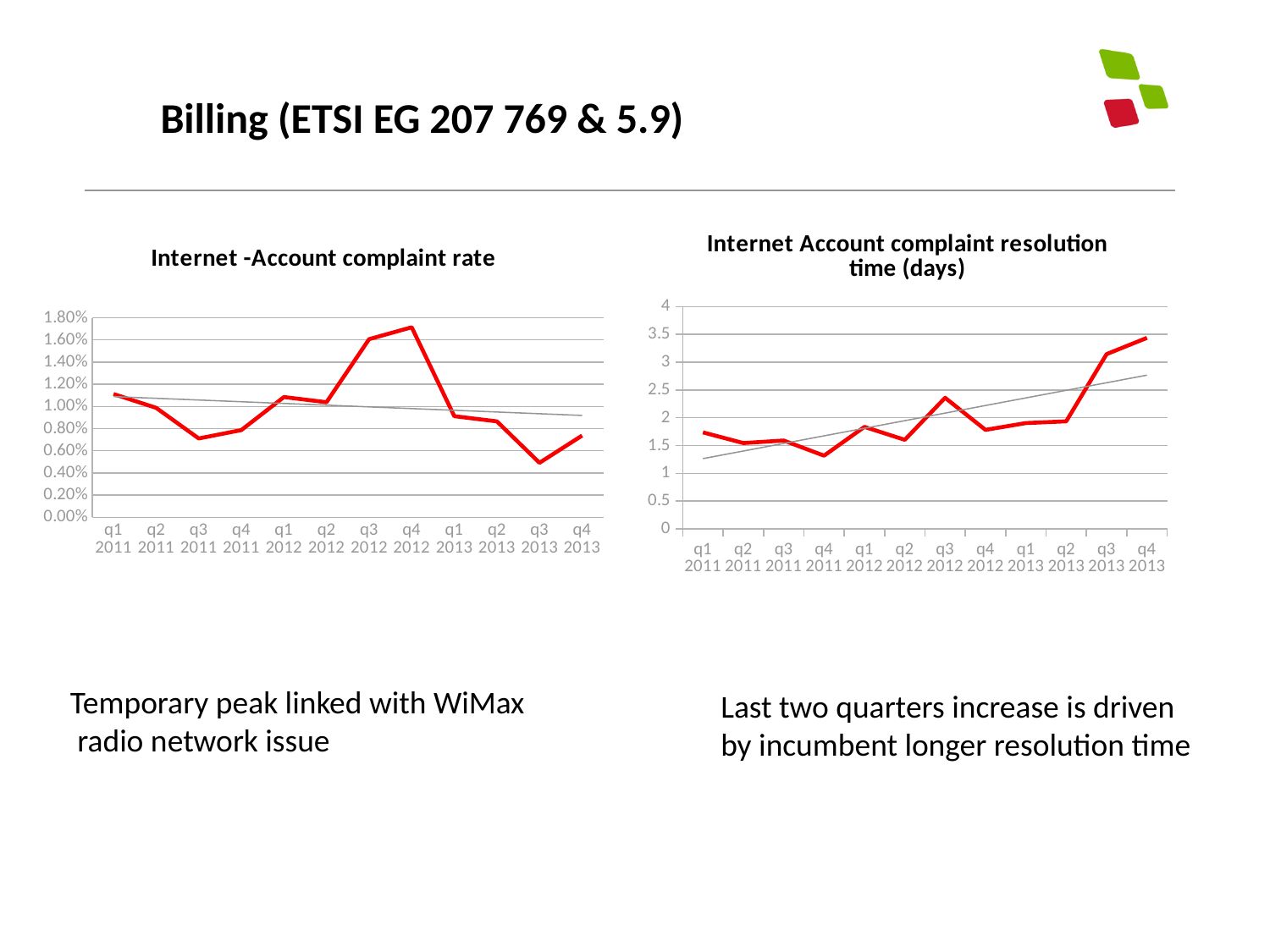
In the 'Internet -Account complaint rate' chart, which quarter has the highest complaint rate? q4 2012 In the 'Internet Account complaint resolution time (days)' chart, which quarter has the highest resolution time? q4 2013 In the 'Internet -Account complaint rate' chart, which is larger, the value for q4 2012 or the value for q3 2011? q4 2012 In the 'Internet -Account complaint rate' chart, is the value for q4 2012 greater or less than 1.40%? greater In the 'Internet Account complaint resolution time (days)' chart, which quarter has the lowest resolution time? q4 2011 How many quarters are plotted on the x axis of the 'Internet -Account complaint rate' chart? 12 What kind of chart is the 'Internet Account complaint resolution time (days)' chart? line chart In the 'Internet Account complaint resolution time (days)' chart, is the value for q4 2013 greater or less than 3? greater In the 'Internet -Account complaint rate' chart, is the value for q3 2013 greater or less than 0.60%? less In the 'Internet -Account complaint rate' chart, which quarter has the lowest complaint rate? q3 2013 In the 'Internet Account complaint resolution time (days)' chart, do the values generally rise or fall from q1 2011 to q4 2013? rise What kind of chart is the 'Internet -Account complaint rate' chart? line chart